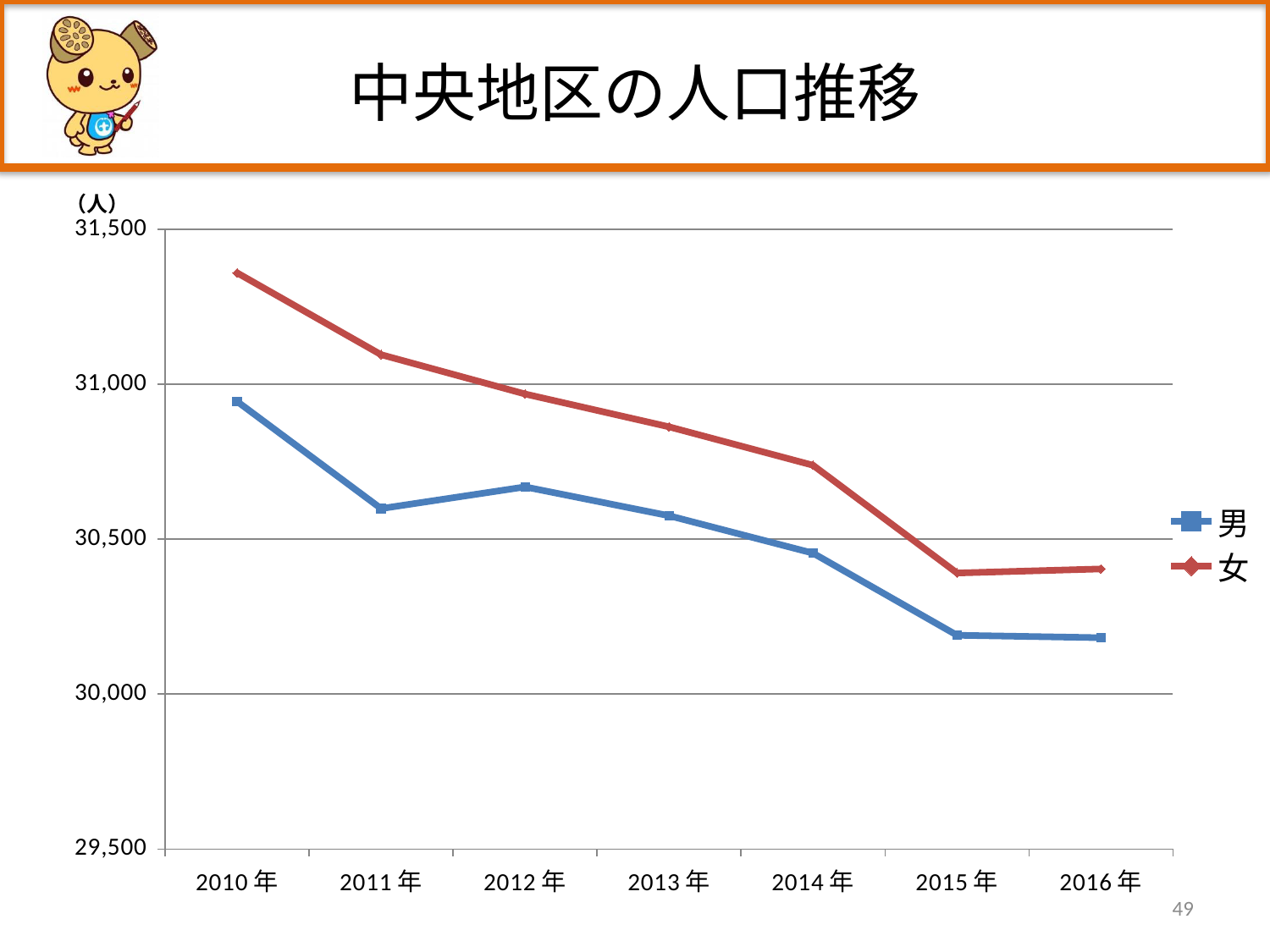
Is the value for 女 in 2014年 greater or less than 30,500? greater What kind of chart is shown on the slide? line chart What is the title of the chart? 中央地区の人口推移 How many series does the legend list? 2 How many years are plotted along the x axis? 7 In which year is the value for 女 highest? 2010年 Do the values for 女 generally rise or fall from 2010年 to 2016年? fall What unit is shown at the top of the vertical axis? (人) Is the value for 女 in 2010年 greater or less than 31,000? greater In 2013年, which series has the larger value, 男 or 女? 女 Is the value for 男 in 2015年 greater or less than 30,500? less